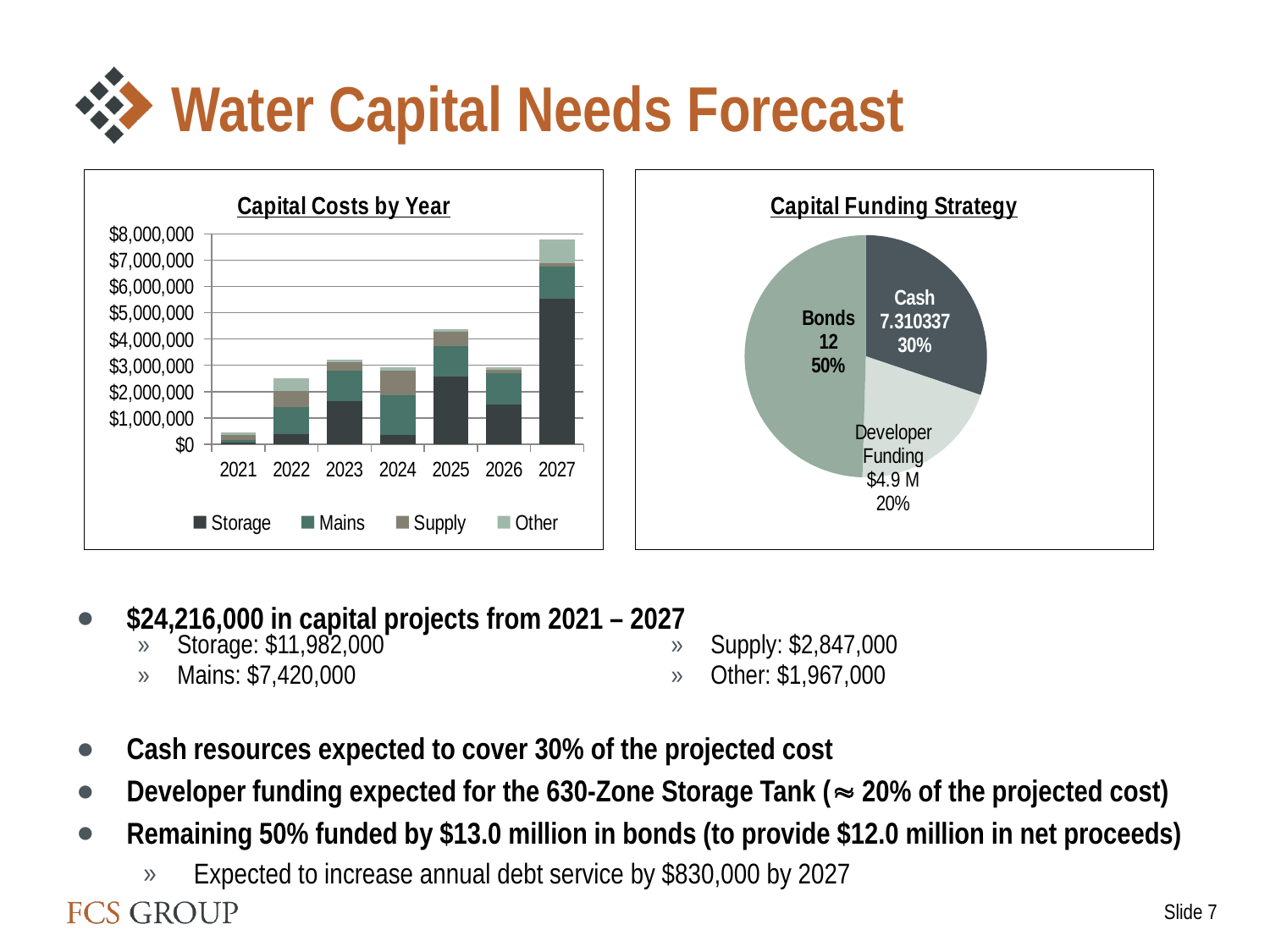
In the 'Capital Costs by Year' chart, which year has the larger total bar, 2025 or 2022? 2025 In the 'Capital Costs by Year' chart, which year has the tallest stacked bar? 2027 In the 'Capital Costs by Year' chart, how many years are shown on the x axis? 7 In the 'Capital Costs by Year' chart, is the total bar for 2025 greater or less than $4,000,000? greater In the 'Capital Costs by Year' chart, is the total bar for 2027 greater or less than $7,000,000? greater In the 'Capital Funding Strategy' pie chart, what share is labelled for Bonds? 50% In the 'Capital Funding Strategy' pie chart, which slice is the smallest? Developer Funding In the 'Capital Costs by Year' chart, which year has the shortest stacked bar? 2021 What kind of chart is the 'Capital Costs by Year' chart? Bar chart In the 'Capital Costs by Year' chart, how many series does the legend list? 4 In the 'Capital Costs by Year' chart, is the total bar for 2021 greater or less than $1,000,000? less What kind of chart is the 'Capital Funding Strategy' chart? Pie chart